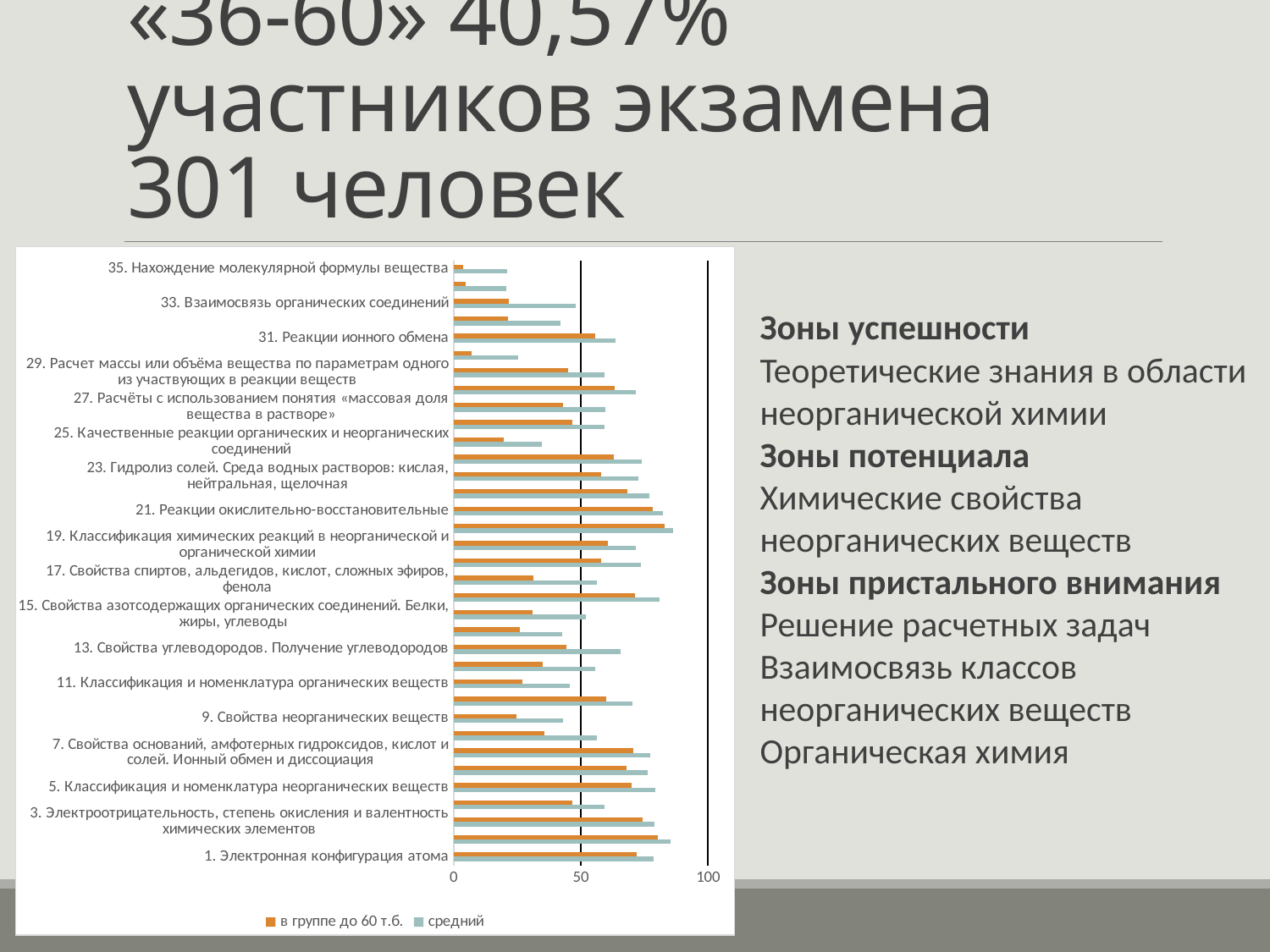
How many categories (topics) are plotted on the chart? 35 What are the two series named in the chart legend? в группе до 60 т.б.; средний Is the value of 'в группе до 60 т.б.' for '21. Реакции окислительно-восстановительные' greater or less than 50? greater What kind of chart is shown on the slide? bar chart What is the highest value shown on the chart's horizontal axis? 100 Is the value of 'средний' for '1. Электронная конфигурация атома' greater or less than 50? greater For '35. Нахождение молекулярной формулы вещества', which series has the larger value: 'в группе до 60 т.б.' or 'средний'? средний Is the value of 'в группе до 60 т.б.' for '35. Нахождение молекулярной формулы вещества' greater or less than 50? less Which category has the lowest value for the series 'в группе до 60 т.б.'? 35. Нахождение молекулярной формулы вещества How many series does the chart legend list? 2